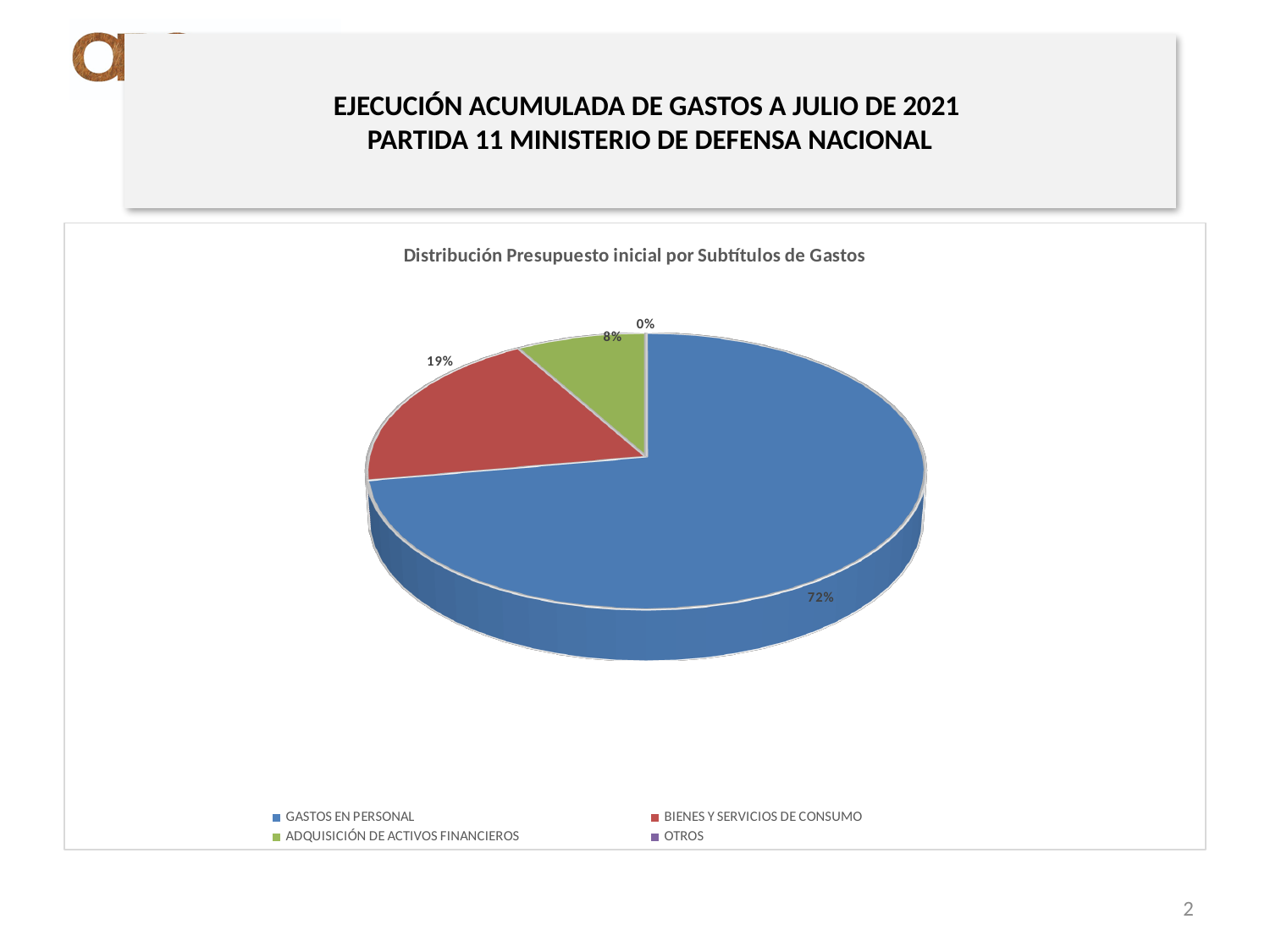
What is the title of the chart? Distribución Presupuesto inicial por Subtítulos de Gastos What colour is the slice for BIENES Y SERVICIOS DE CONSUMO? Red Which is larger, the share for BIENES Y SERVICIOS DE CONSUMO or the share for ADQUISICIÓN DE ACTIVOS FINANCIEROS? BIENES Y SERVICIOS DE CONSUMO What type of chart is shown on the slide? Pie chart Which category has the largest share of the pie? GASTOS EN PERSONAL Which category has the smallest share of the pie? OTROS What is the difference in percentage points between GASTOS EN PERSONAL and BIENES Y SERVICIOS DE CONSUMO? 53 percentage points What share of the pie does GASTOS EN PERSONAL represent? 72% What share of the pie does ADQUISICIÓN DE ACTIVOS FINANCIEROS represent? 8% What share of the pie does OTROS represent? 0% How many categories does the legend list? 4